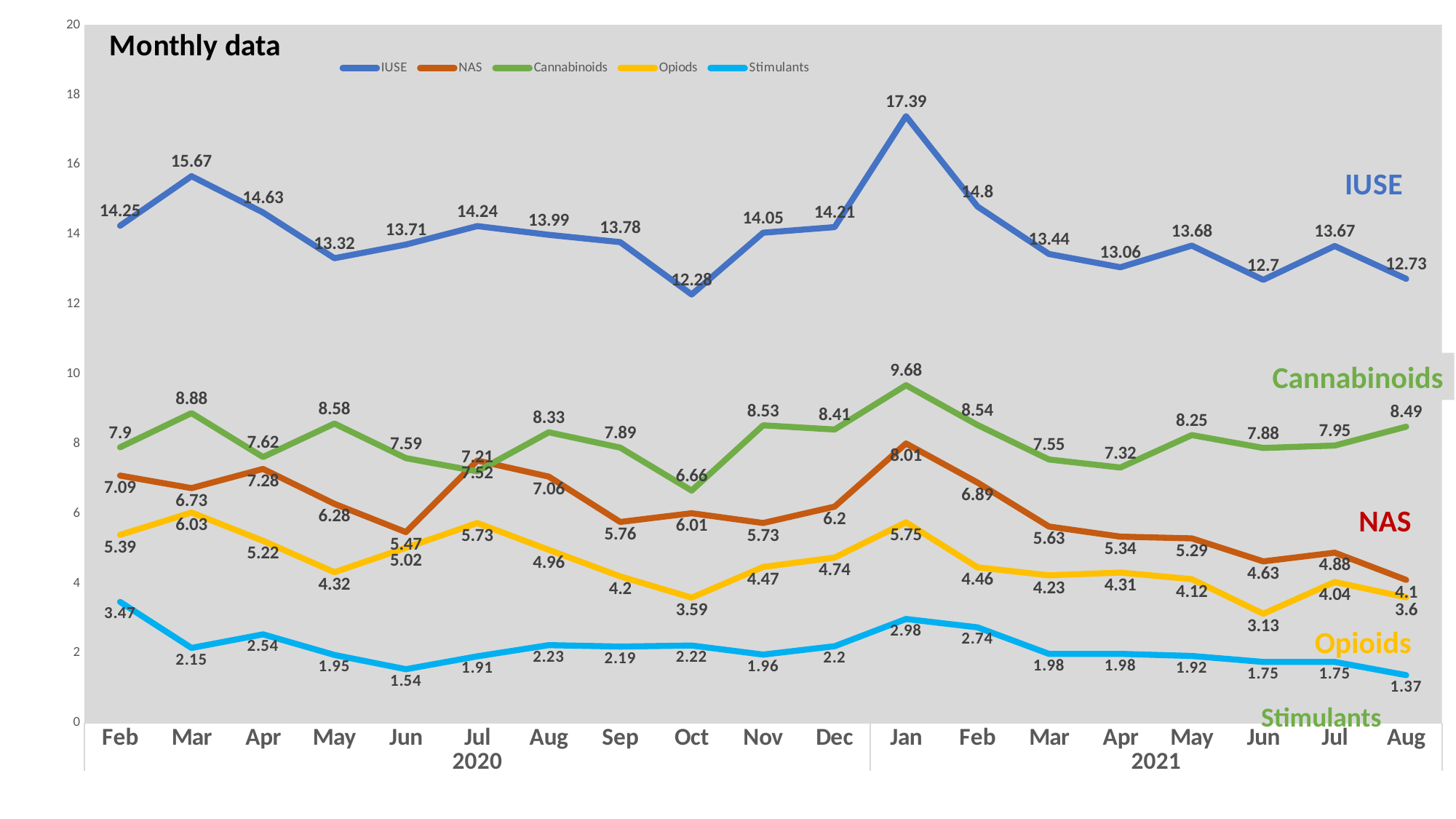
What is the Stimulants value for Feb 2020? 3.47 What type of chart is shown on the slide? Line chart What is the difference between the IUSE values for Jan 2021 and Feb 2021? 2.59 In which month is the Stimulants series at its lowest? Aug 2021 Does the NAS series rise or fall from Jan 2021 to Aug 2021? Fall Which is larger, the Cannabinoids value for Mar 2020 or for Aug 2021? Mar 2020 What is the Opioids value for Oct 2020? 3.59 In which month is the IUSE series at its highest? Jan 2021 How many monthly data points are plotted along the x axis? 19 In which month is the IUSE series at its lowest? Oct 2020 What is the IUSE value for Jan 2021? 17.39 How many series does the legend list? 5